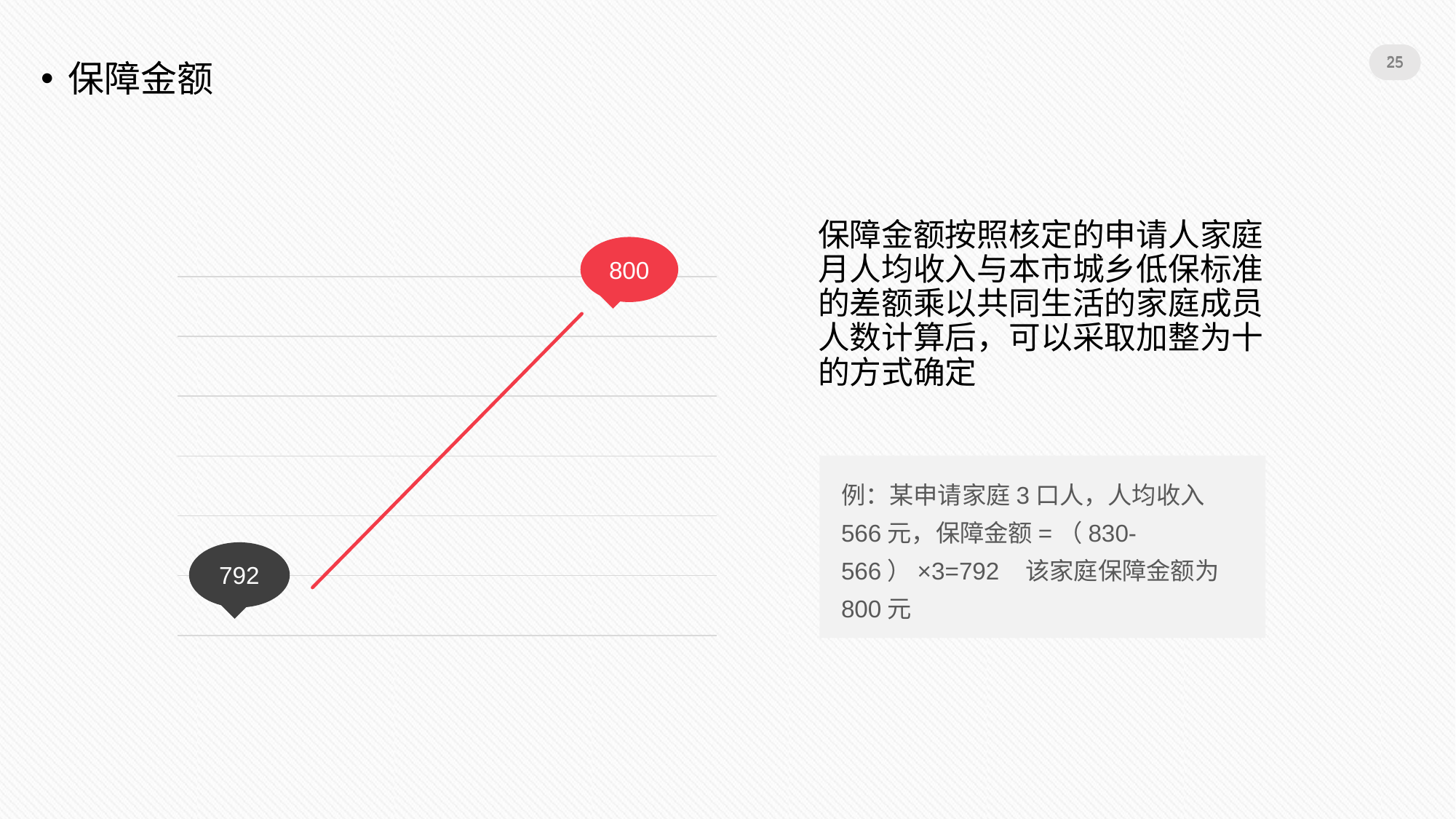
What colour is the callout label for the value 792? dark grey Which of the two labelled values on the line chart is the highest? 800 What colour is the plotted line on the chart? red How many data points are plotted on the line chart? 2 What value is shown in the dark callout at the lower-left end of the line? 792 Does the line rise or fall from left to right? rises Is the value at the right end of the line larger or smaller than the value at the left end? larger What is the difference between the two labelled values on the line chart? 8 Which of the two labelled values on the line chart is the lowest? 792 What value is shown in the red callout at the upper-right end of the line? 800 What kind of chart is shown on the slide? line chart